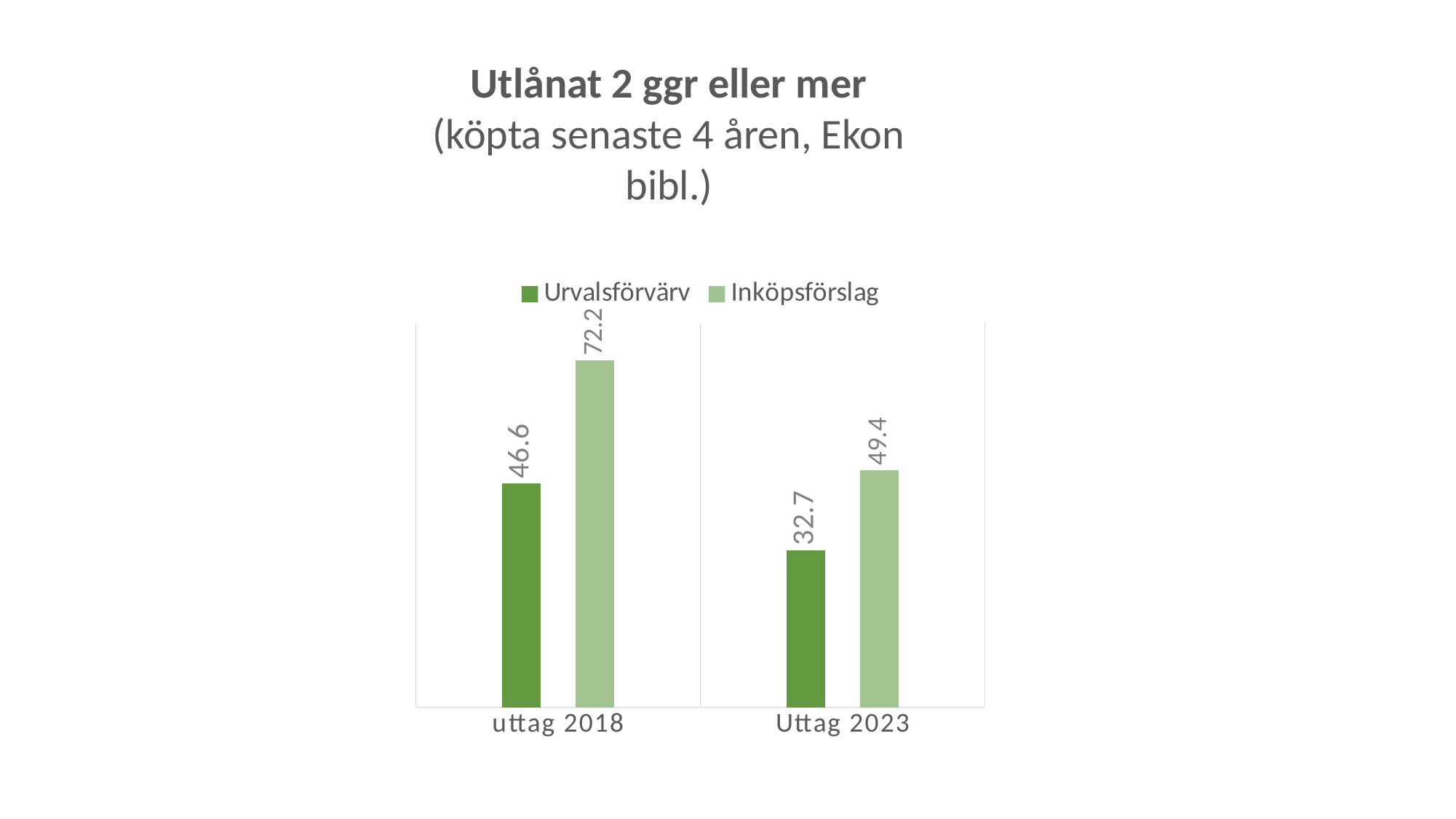
How many categories are shown on the x axis? 2 Which is larger: Urvalsförvärv in uttag 2018 or Inköpsförslag in Uttag 2023? Inköpsförslag in Uttag 2023 What is the value for Urvalsförvärv in uttag 2018? 46.6 Which series has the highest value in uttag 2018? Inköpsförslag Which bar has the lowest value in the chart? Urvalsförvärv in Uttag 2023 What is the difference between Inköpsförslag and Urvalsförvärv in uttag 2018? 25.6 What is the difference between the Inköpsförslag values for uttag 2018 and Uttag 2023? 22.8 What is the value for Inköpsförslag in Uttag 2023? 49.4 What kind of chart is shown on the slide? Bar chart What is the value for Urvalsförvärv in Uttag 2023? 32.7 How many series does the legend list? 2 What is the value for Inköpsförslag in uttag 2018? 72.2